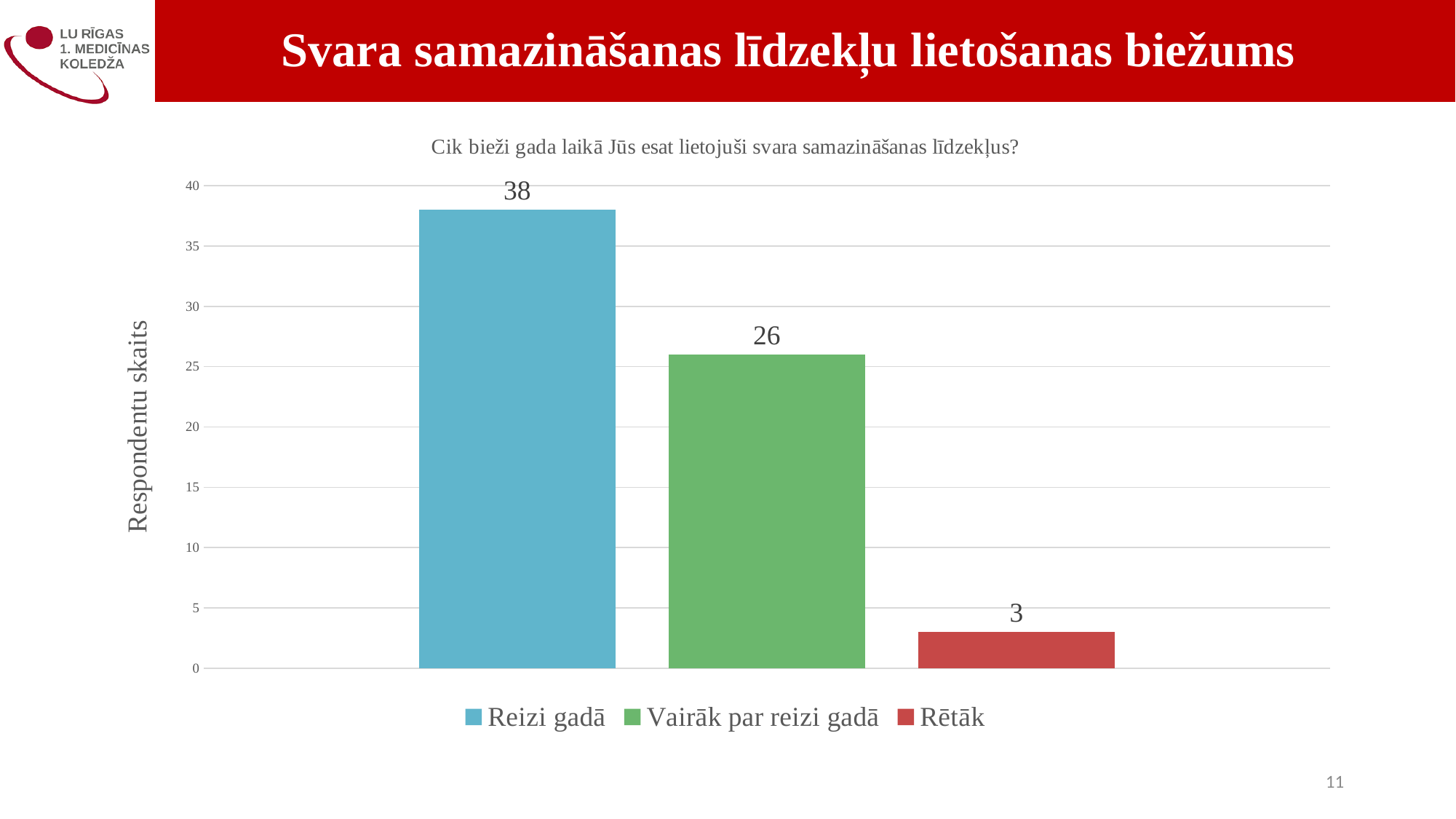
What is the difference between the values for "Vairāk par reizi gadā" and "Rētāk"? 23 How many categories are shown in the chart? 3 What is the difference between the values for "Reizi gadā" and "Vairāk par reizi gadā"? 12 What kind of chart is shown on the slide? bar chart What is the value for "Rētāk"? 3 What is the label of the vertical axis? Respondentu skaits Which is larger, the value for "Vairāk par reizi gadā" or the value for "Rētāk"? Vairāk par reizi gadā Which category has the highest value? Reizi gadā What is the value for "Reizi gadā"? 38 What is the value for "Vairāk par reizi gadā"? 26 Is the value for "Reizi gadā" greater or less than 35? greater Which category has the lowest value? Rētāk